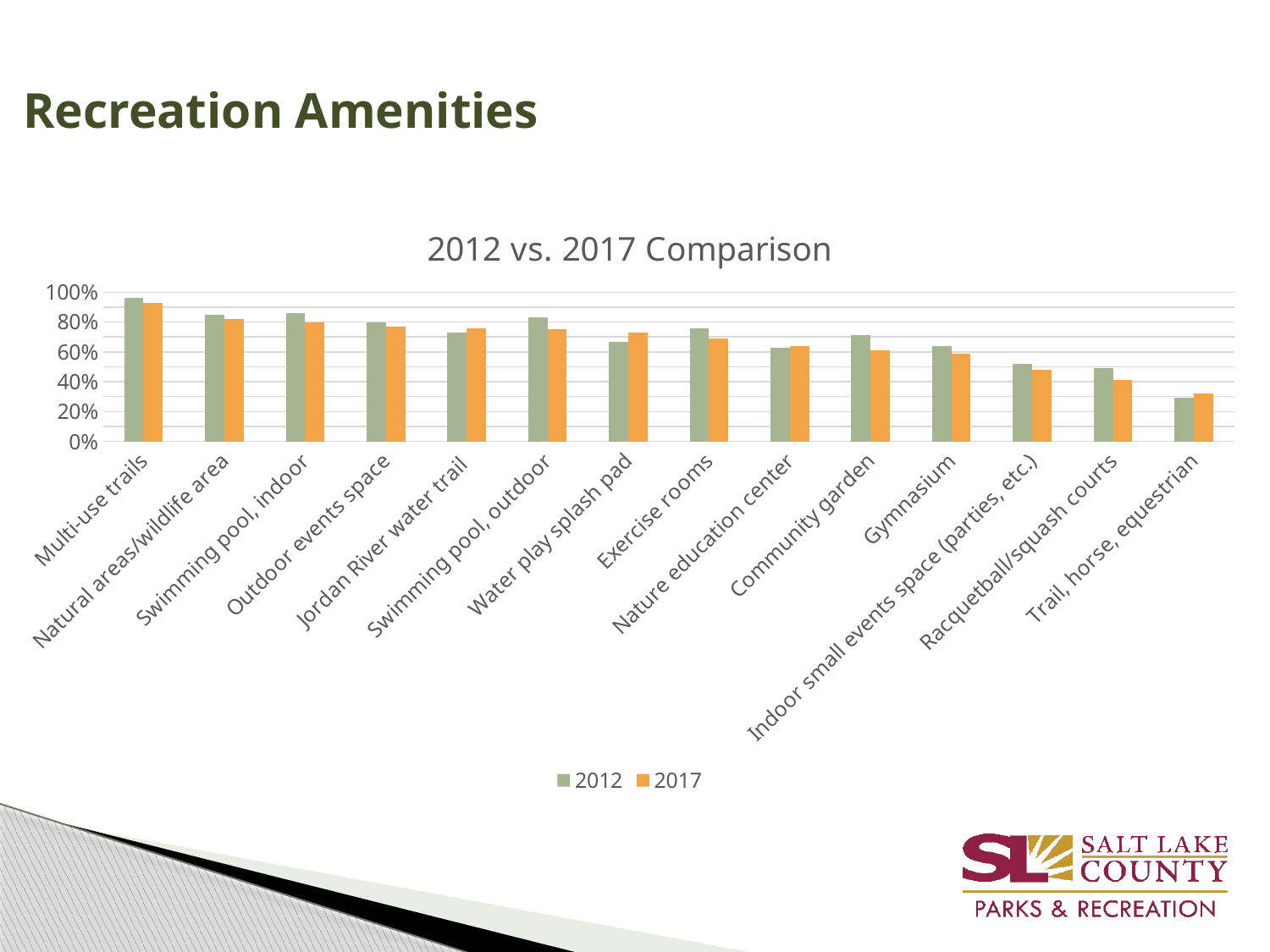
What kind of chart is shown on the slide? Bar chart Which amenity has the highest 2012 value? Multi-use trails What is the title of the chart? 2012 vs. 2017 Comparison How many series does the legend list? 2 For Water play splash pad, which year has the larger value, 2012 or 2017? 2017 Is the 2017 value for Racquetball/squash courts greater or less than 60%? less Do the 2012 values generally rise or fall moving from left to right along the x axis? fall Which amenity has the lowest 2017 value? Trail, horse, equestrian For Swimming pool, outdoor, which year has the larger value, 2012 or 2017? 2012 Is the 2012 value for Multi-use trails greater or less than 80%? greater Is the 2017 value for Trail, horse, equestrian greater or less than 40%? less How many amenity categories are shown on the x axis? 14